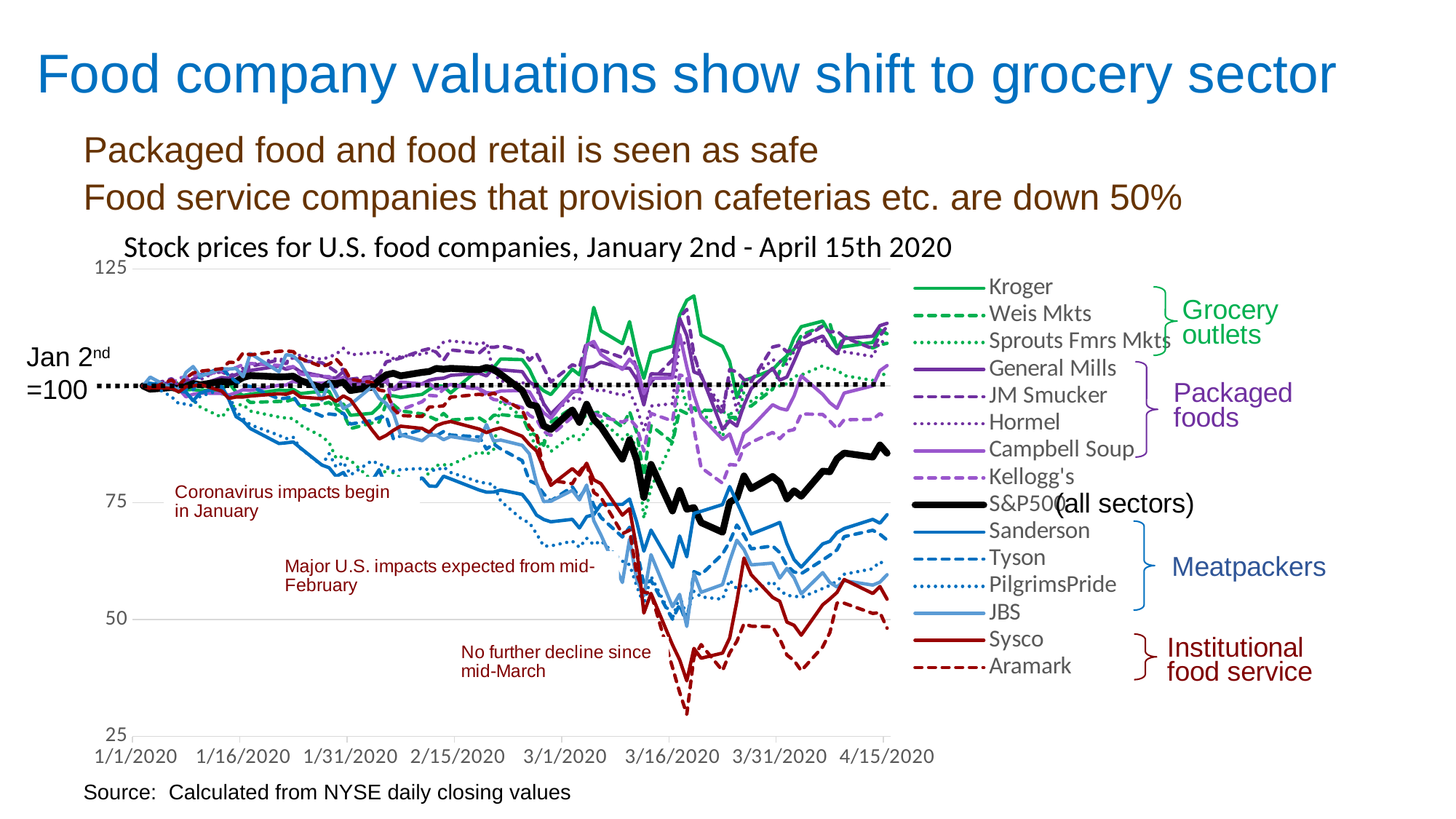
What is the title of the chart? Stock prices for U.S. food companies, January 2nd - April 15th 2020 What index value are all the stock price series set to on January 2nd? 100 Which legend group does Sysco belong to? Institutional food service Is the lowest value reached by Aramark in mid-March greater or less than 50? less On 4/15/2020, which is higher, General Mills or Tyson? General Mills Is the value for the S&P500 on 4/15/2020 greater or less than 100? less How many series does the chart legend list? 15 Is the value for Sysco on 4/15/2020 greater or less than 75? less What kind of chart is shown on the slide? line chart Does the S&P500 line rise or fall overall from 1/1/2020 to 4/15/2020? fall Which series reaches the lowest value on the chart, Aramark or Kroger? Aramark